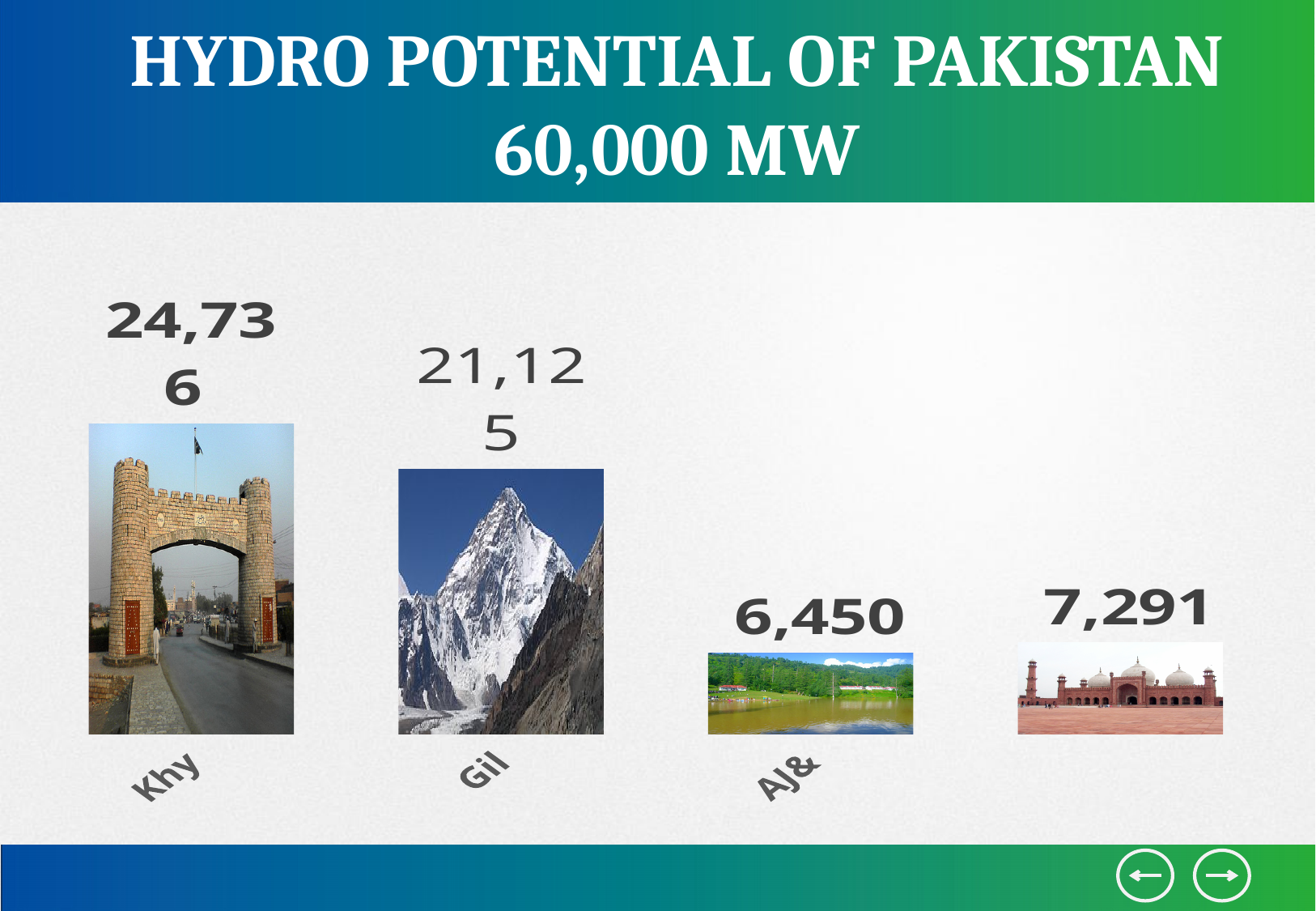
What is the difference between the values for Gil and AJ&? 14,675 What is the value shown for AJ&? 6,450 Which category has the highest value? Khy What is the difference between the values for Khy and Gil? 3,611 How many bars are plotted in the chart? 4 What is the value shown for Khy? 24,736 Which is larger, the value for Khy or the value for Gil? Khy What is the value shown for Gil? 21,125 What is the title of the slide? HYDRO POTENTIAL OF PAKISTAN 60,000 MW Which is larger, the value for Gil or the value for AJ&? Gil Which category has the lowest value? AJ& What kind of chart is shown on the slide? Bar chart